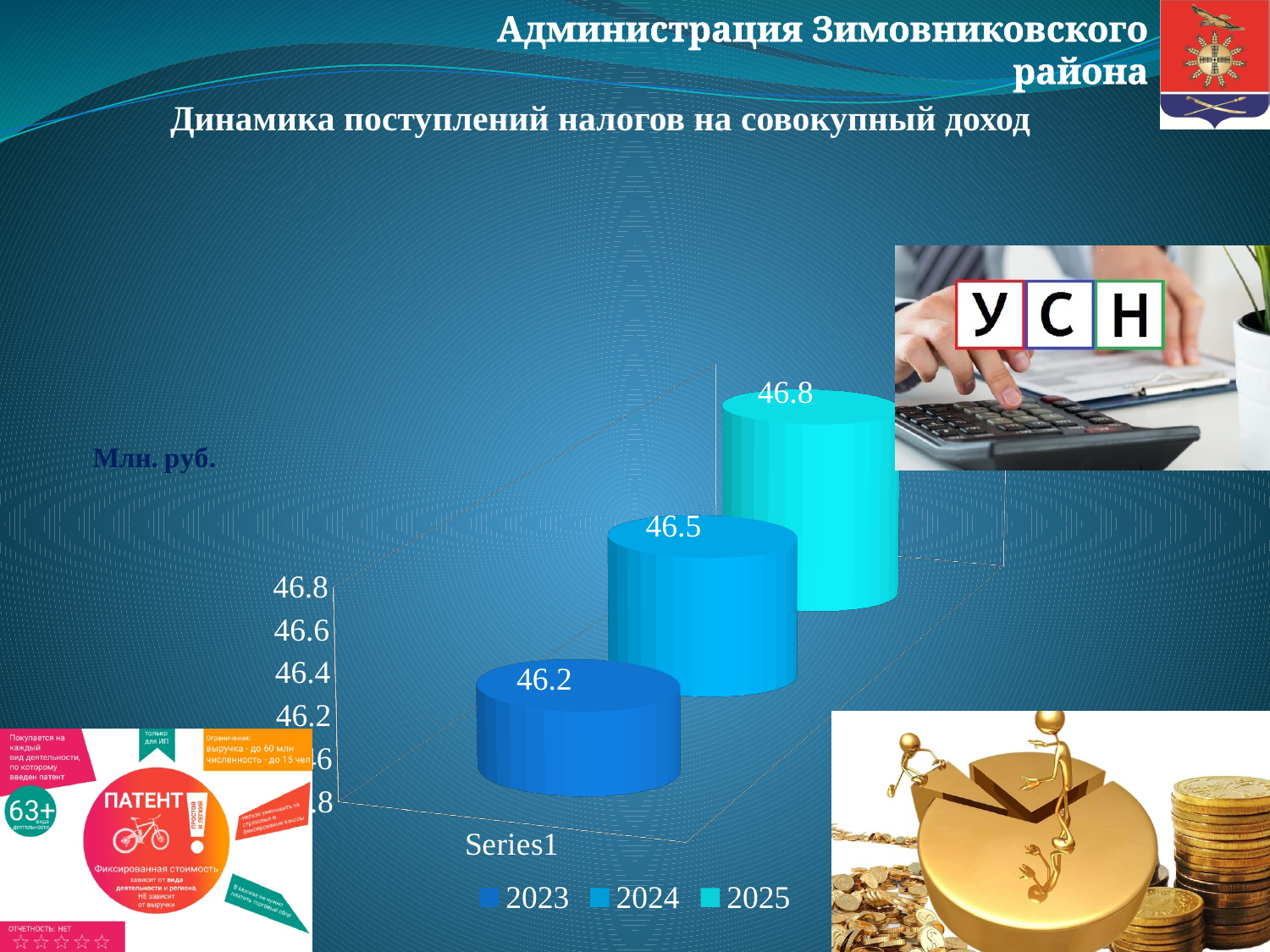
How many entries does the legend list? 3 What is the value for 2024? 46.5 What is the value for 2025? 46.8 What is the difference between the values for 2025 and 2023? 0.6 What is the difference between the values for 2024 and 2023? 0.3 Which year has the lowest value? 2023 What is the value for 2023? 46.2 Which is larger, the value for 2024 or the value for 2025? 2025 Which year has the highest value? 2025 How many bars are plotted on the chart? 3 Do the values rise or fall from 2023 to 2025? rise What kind of chart is shown on the slide? bar chart